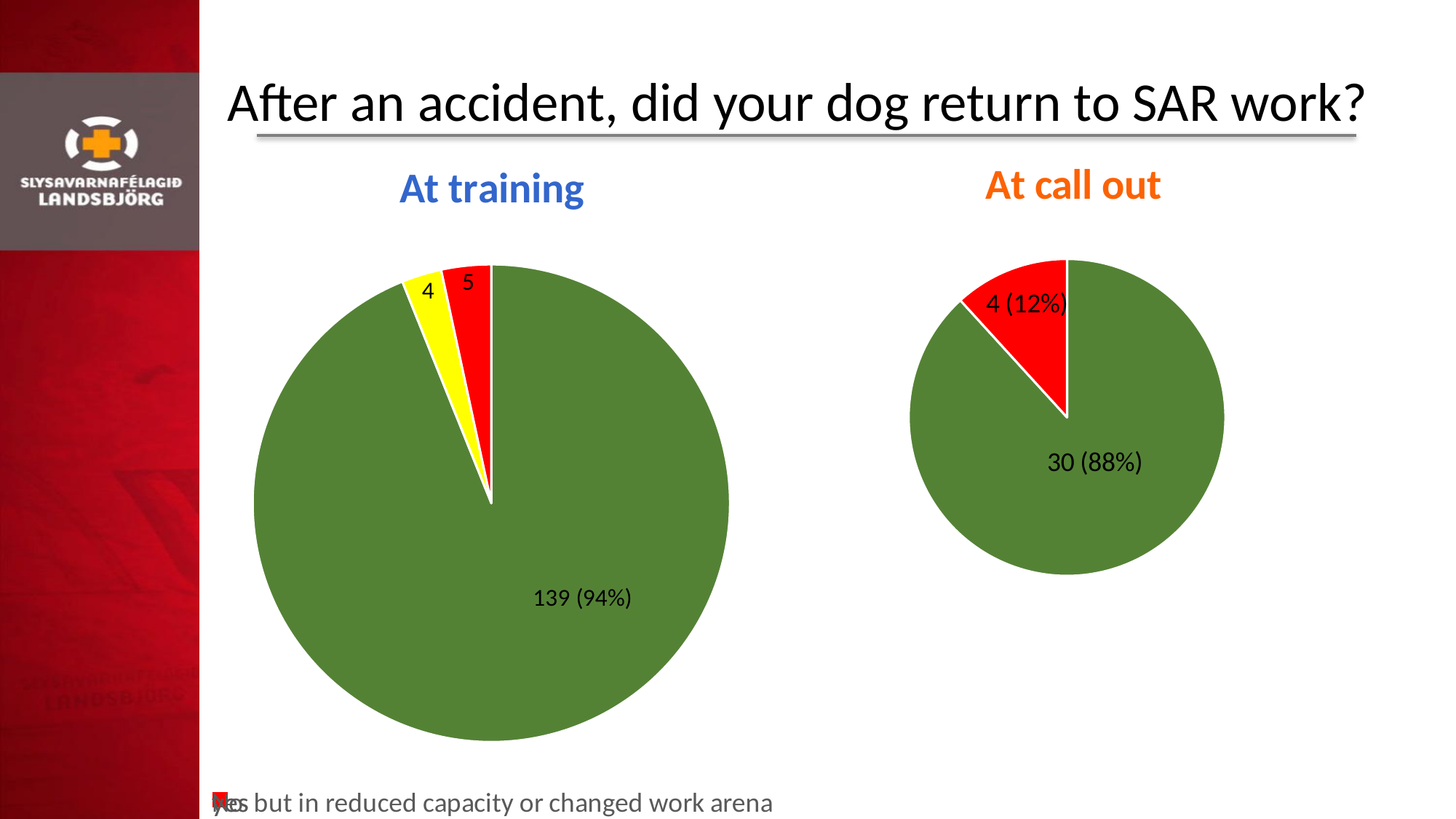
In the "At training" chart, what value is shown on the yellow slice? 4 In the "At training" chart, what value is shown on the red slice? 5 In the "At call out" chart, what value is shown on the red slice? 4 (12%) How many slices does the "At training" pie chart have? 3 In the "At call out" chart, what value is shown on the green slice? 30 (88%) What is the title of the slide above the two pie charts? After an accident, did your dog return to SAR work? In the "At training" chart, what is the total of all three slice values? 148 What kind of chart is the "At training" chart? pie chart In the "At training" chart, what is the difference between the green slice value and the red slice value? 134 In the "At training" chart, what value is shown on the green slice? 139 (94%) How many slices does the "At call out" pie chart have? 2 In the "At training" chart, which slice is the smallest? the yellow slice